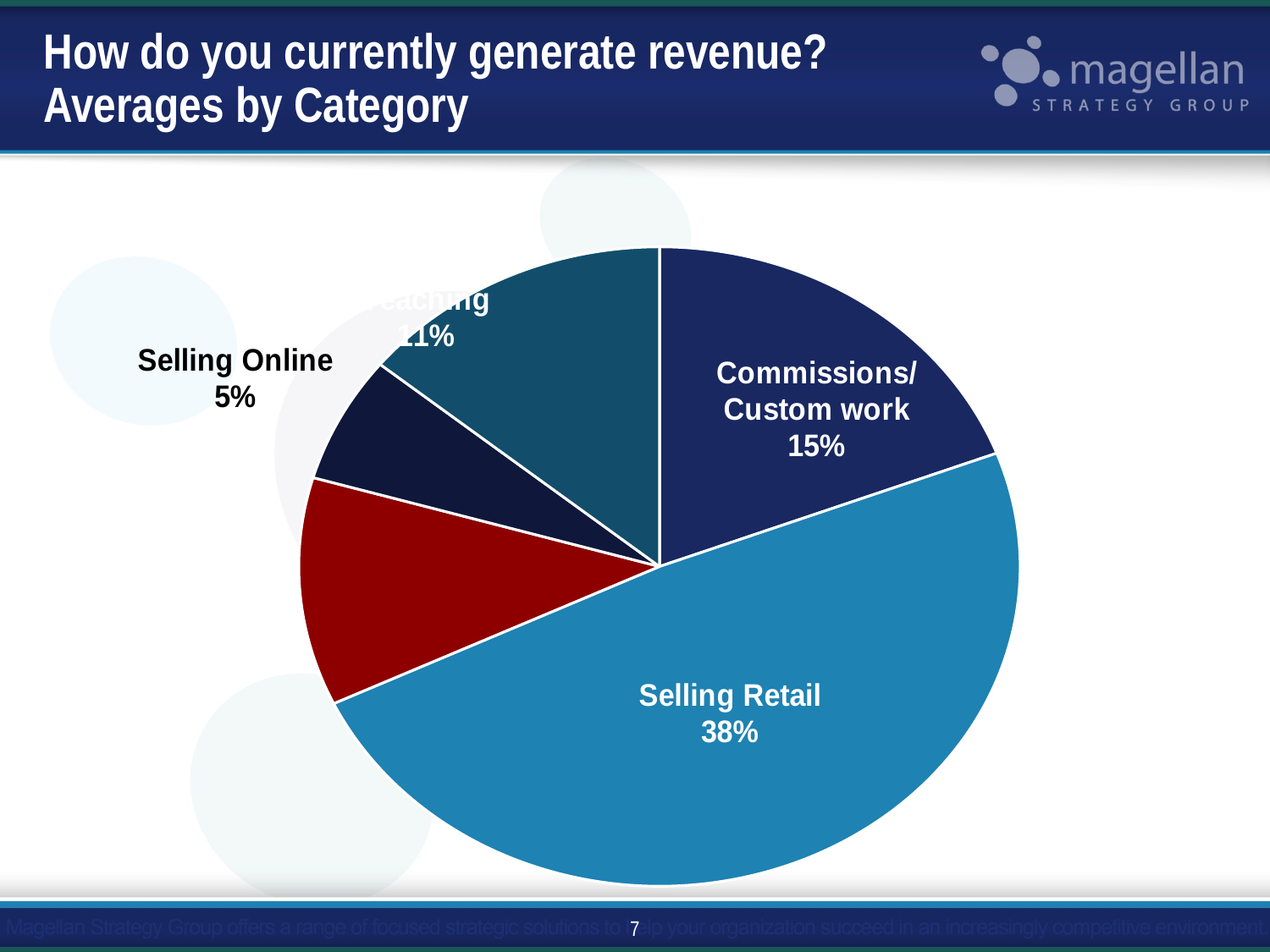
Is the share for Selling Retail greater or less than 50%? less What kind of chart is shown on the slide? pie chart What share of revenue comes from Commissions/Custom work? 15% How many percentage points larger is Commissions/Custom work than Selling Online? 10 How many percentage points larger is Selling Retail than Commissions/Custom work? 23 Which is larger, Selling Retail or Commissions/Custom work? Selling Retail What share of revenue comes from Selling Online? 5% How many slices does the pie chart have? 5 What share of revenue comes from Selling Retail? 38% What is the title of the slide's chart? How do you currently generate revenue? Averages by Category Which category has the smallest slice of the pie? Selling Online Which category has the largest slice of the pie? Selling Retail